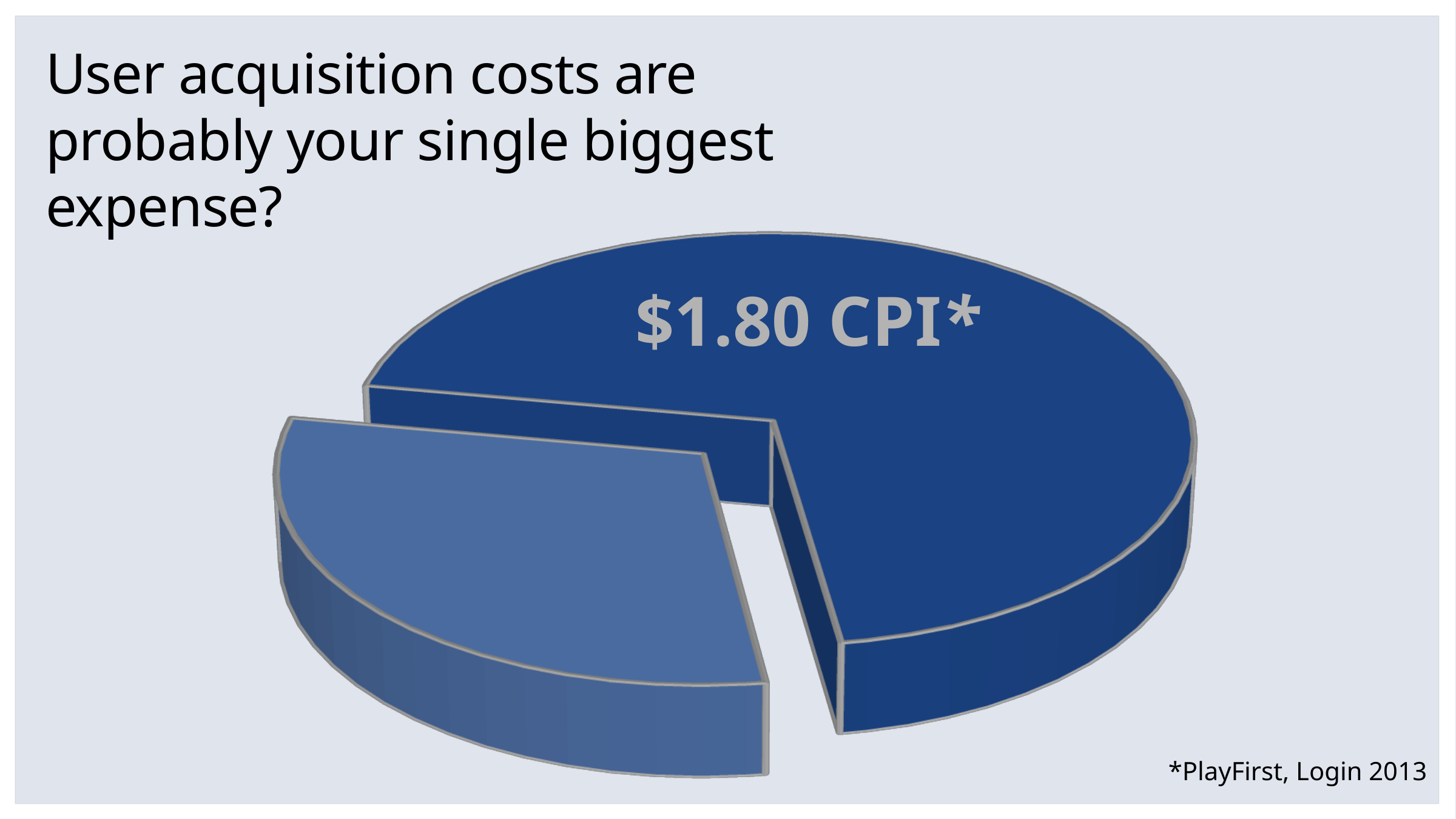
Is the dark blue slice labelled "$1.80 CPI*" more or less than half of the pie? more What kind of chart is shown on the slide? pie chart What label is printed on the large dark blue slice of the pie chart? $1.80 CPI* Which slice of the pie chart is the smallest? the lighter blue exploded slice How many slices does the pie chart have? 2 Which slice of the pie chart is larger, the dark blue slice or the lighter blue exploded slice? the dark blue slice What source is cited in the footnote for the CPI figure? *PlayFirst, Login 2013 What is the title text on the slide above the pie chart? User acquisition costs are probably your single biggest expense?